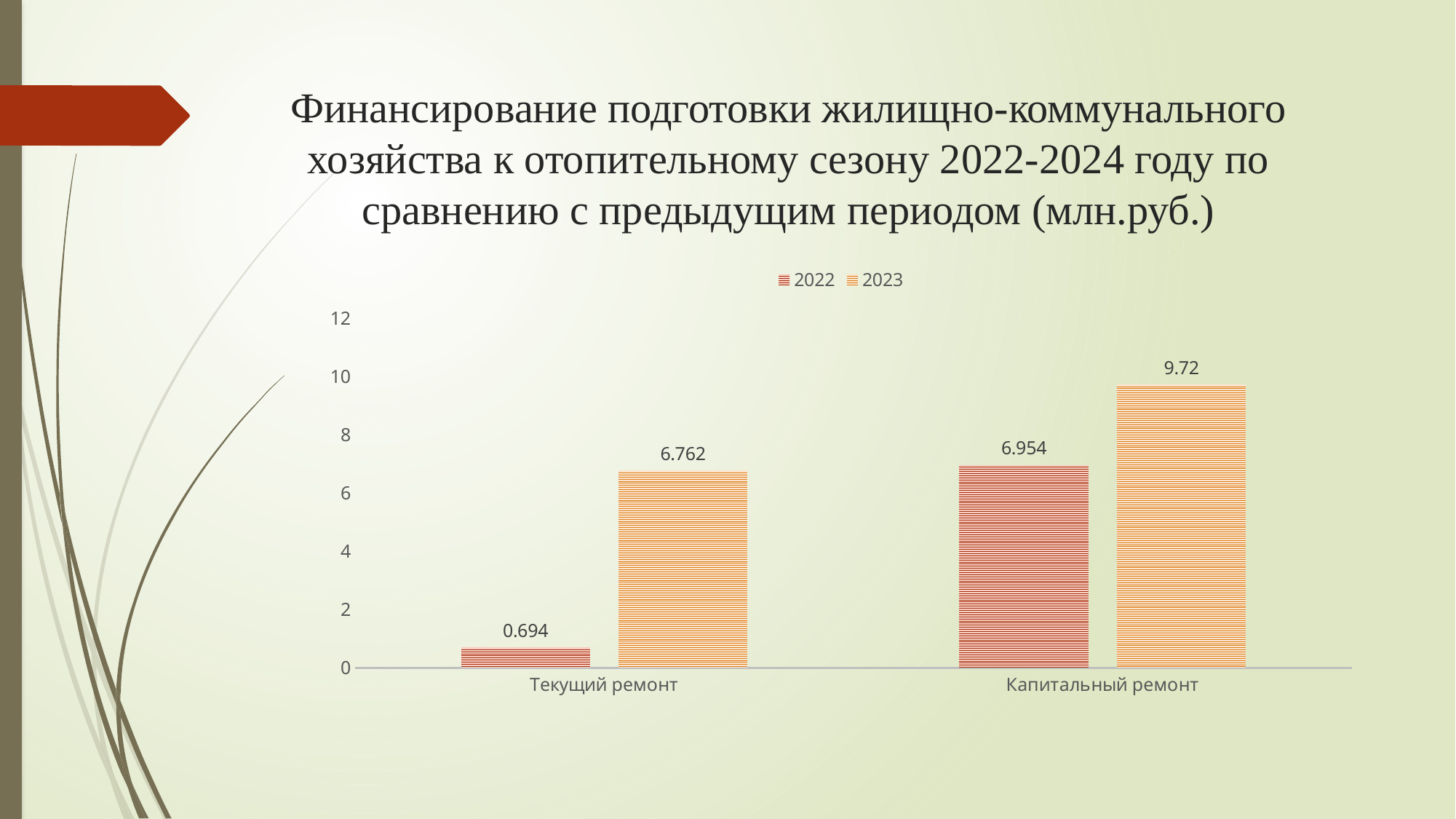
Which bar has the lowest value on the chart? Текущий ремонт, 2022 What kind of chart is shown on the slide? Bar chart Which is larger: the 2023 value for Текущий ремонт or the 2022 value for Капитальный ремонт? 2022 value for Капитальный ремонт What is the value for 2022 in the Текущий ремонт category? 0.694 Which bar has the highest value on the chart? Капитальный ремонт, 2023 What is the value for 2023 in the Капитальный ремонт category? 9.72 How many categories are shown on the x axis? 2 What is the value for 2022 in the Капитальный ремонт category? 6.954 What is the value for 2023 in the Текущий ремонт category? 6.762 What is the difference between the 2023 and 2022 values for Текущий ремонт? 6.068 What is the difference between the 2023 and 2022 values for Капитальный ремонт? 2.766 How many series does the legend list? 2